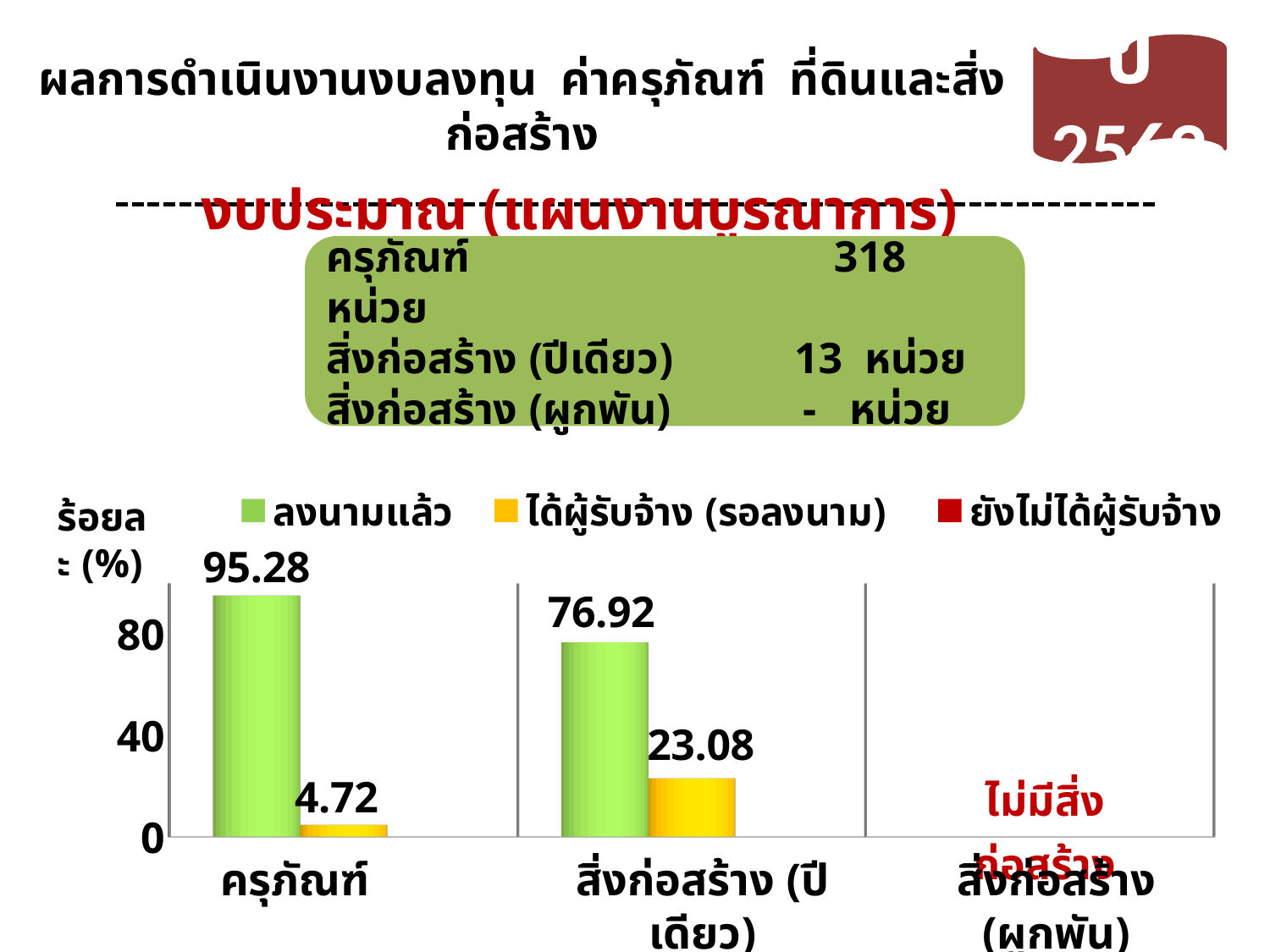
What is the difference between the ลงนามแล้ว values for ครุภัณฑ์ and สิ่งก่อสร้าง (ปีเดียว)? 18.36 What is the value of ได้ผู้รับจ้าง (รอลงนาม) for สิ่งก่อสร้าง (ปีเดียว)? 23.08 Is the ลงนามแล้ว value for สิ่งก่อสร้าง (ปีเดียว) greater or less than 80? less What is the value of ได้ผู้รับจ้าง (รอลงนาม) for ครุภัณฑ์? 4.72 Which category has the highest ลงนามแล้ว value? ครุภัณฑ์ Which is larger: ได้ผู้รับจ้าง (รอลงนาม) for ครุภัณฑ์ or for สิ่งก่อสร้าง (ปีเดียว)? สิ่งก่อสร้าง (ปีเดียว) What is the difference between the ลงนามแล้ว and ได้ผู้รับจ้าง (รอลงนาม) values for สิ่งก่อสร้าง (ปีเดียว)? 53.84 How many series does the legend list? 3 What is the value of ลงนามแล้ว for สิ่งก่อสร้าง (ปีเดียว)? 76.92 What text is shown in place of bars for the สิ่งก่อสร้าง (ผูกพัน) category? ไม่มีสิ่งก่อสร้าง What is the value of ลงนามแล้ว for ครุภัณฑ์? 95.28 What kind of chart is shown on the slide? bar chart